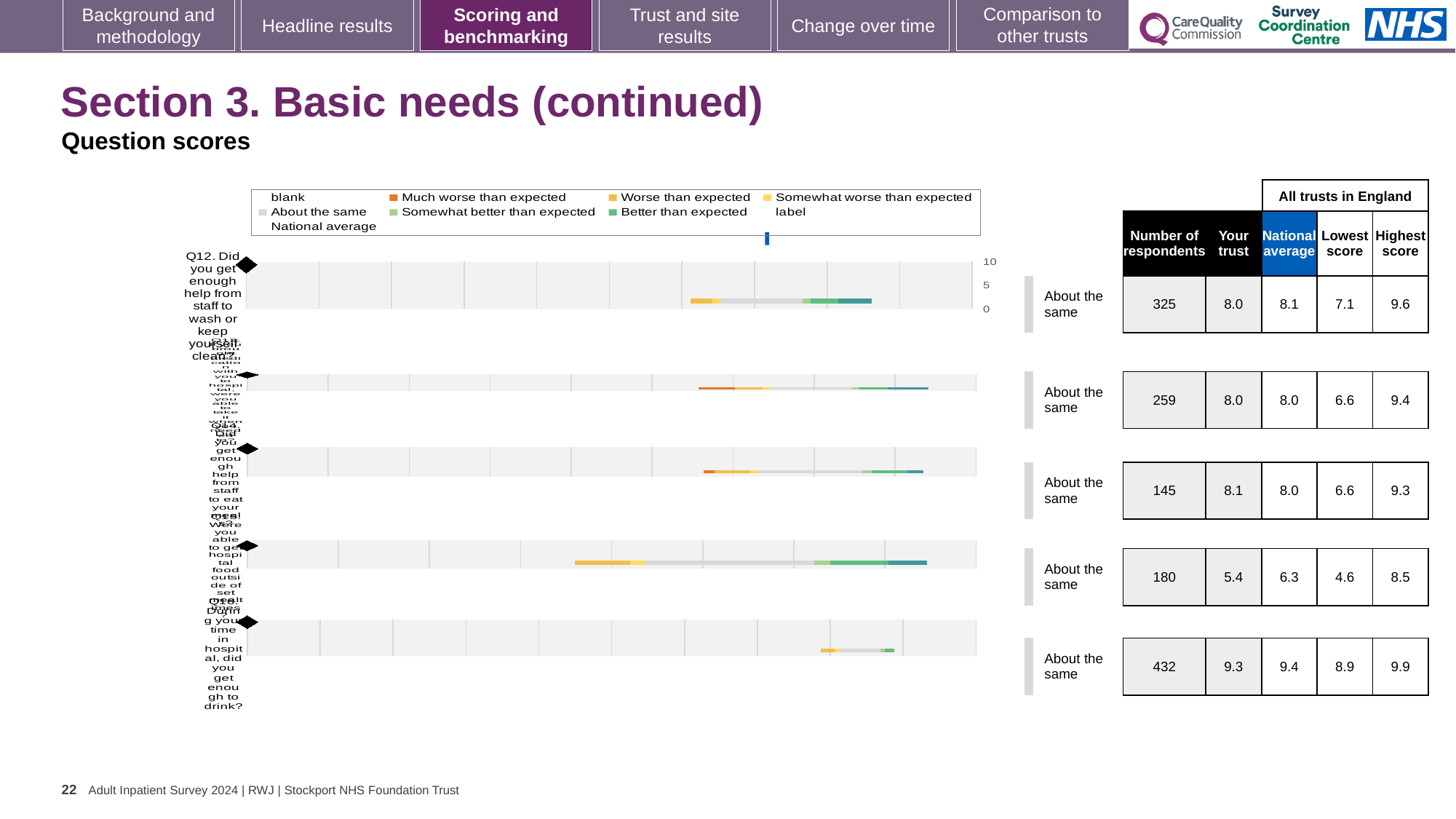
How many respondents are listed for the fourth row of the chart? 180 What kind of chart is shown on the slide? bar chart What benchmark category label is shown next to every row of the chart? About the same What is the national average score for Q12 (help from staff to wash or keep yourself clean)? 8.1 For Q12, what is the difference between the highest score (9.6) and the lowest score (7.1) across all trusts in England? 2.5 What is the lowest score across all trusts in England for the bottom row (432 respondents)? 8.9 In the fourth row, which is larger: the 'Your trust' score or the national average? the national average (6.3) How many question rows (bars) are plotted in the chart? 5 What is the 'Your trust' score for Q12 (help from staff to wash or keep yourself clean)? 8.0 In the fourth row, how much higher is the national average (6.3) than the 'Your trust' score (5.4)? 0.9 Which row has the highest 'Your trust' score? the bottom (fifth) row, 9.3 Which row has the lowest 'Your trust' score? the fourth row, 5.4